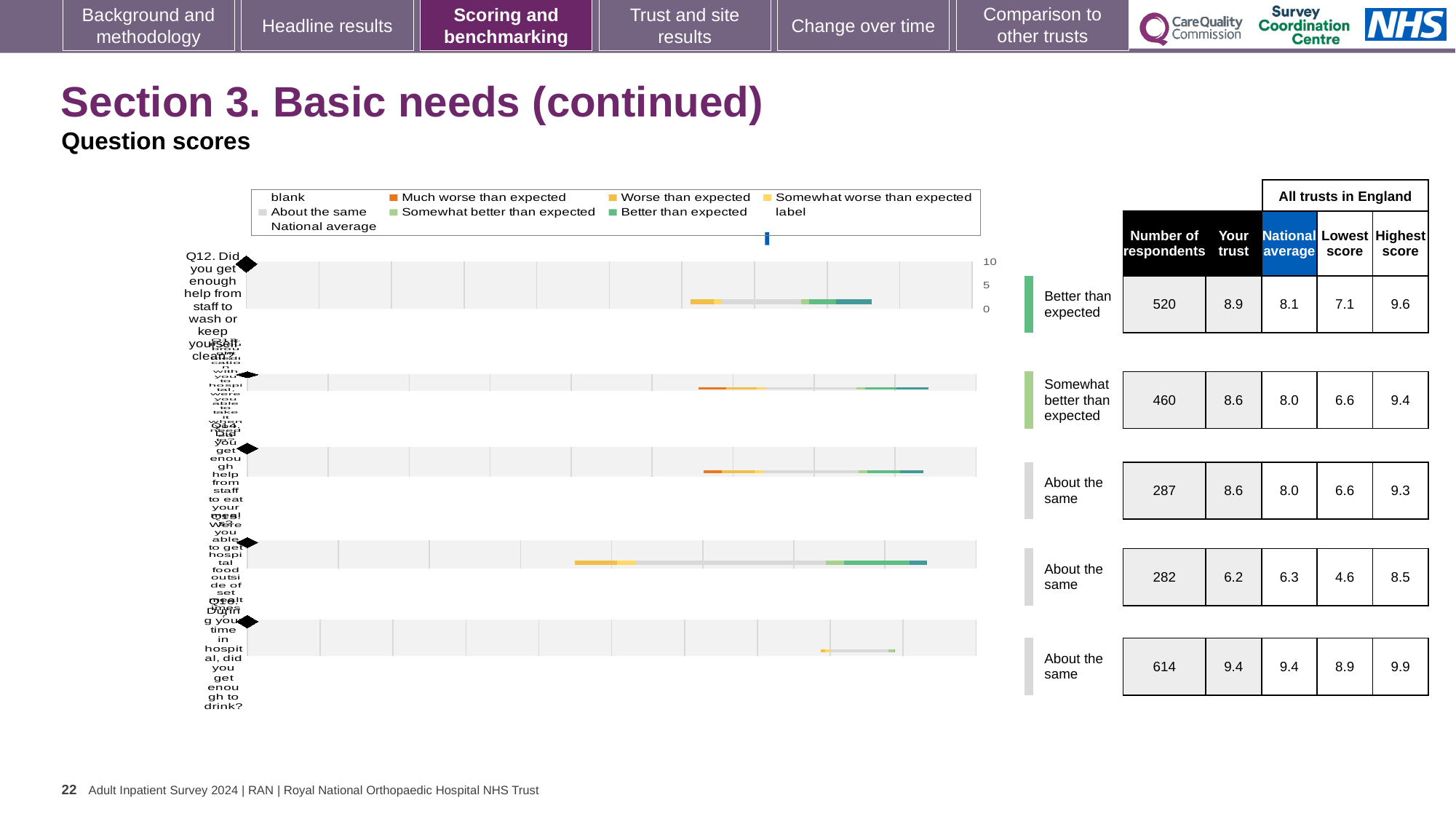
What kind of chart is shown on the slide? Bar chart In the table beside the chart, which row has the lowest 'Your trust' score? The fourth row (282 respondents), 6.2 In the table beside the chart, what is the national average for the first row (Q12)? 8.1 In the table beside the chart, what is the 'Your trust' score for the first row (Q12, help from staff to wash or keep yourself clean)? 8.9 How many question rows (bars) does the chart show? 5 For the first row (Q12), which is larger: the 'Your trust' score or the national average? Your trust In the table beside the chart, how many respondents are listed for the first row (Q12)? 520 What benchmark category is shown for the first row (Q12)? Better than expected In the table beside the chart, which row has the highest 'Your trust' score? The last row (614 respondents), 9.4 What is the subtitle shown under the slide title 'Section 3. Basic needs (continued)'? Question scores For the first row (Q12), what is the difference between the 'Your trust' score and the national average? 0.8 In the chart legend, what colour represents 'Much worse than expected'? Orange